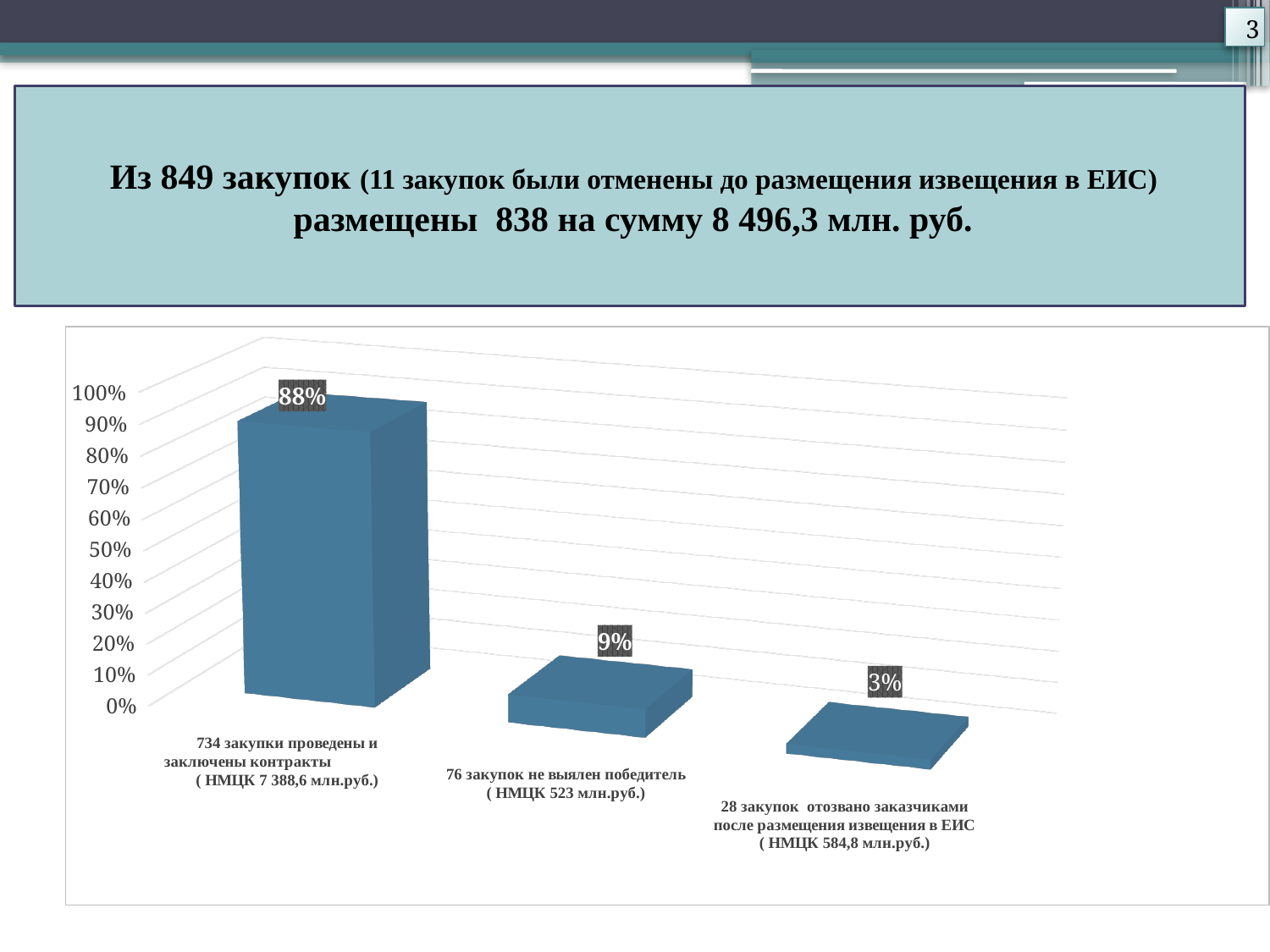
How many categories are shown in the chart? 3 What is the value for the category '76 закупок не выялен победитель'? 9% Which category has the lowest value? 28 закупок отозвано заказчиками после размещения извещения в ЕИС What kind of chart is shown on the slide? bar chart What is the value for the category '734 закупки проведены и заключены контракты'? 88% What is the difference between the values for '76 закупок не выялен победитель' and '28 закупок отозвано заказчиками после размещения извещения в ЕИС'? 6% Which category has the highest value? 734 закупки проведены и заключены контракты Which is larger: the value for '76 закупок не выялен победитель' or for '28 закупок отозвано заказчиками после размещения извещения в ЕИС'? 76 закупок не выялен победитель What is the difference between the values for '734 закупки проведены и заключены контракты' and '76 закупок не выялен победитель'? 79% Is the value for '734 закупки проведены и заключены контракты' greater or less than 50%? greater What is the value for the category '28 закупок отозвано заказчиками после размещения извещения в ЕИС'? 3% Do the values rise or fall from left to right across the categories? fall